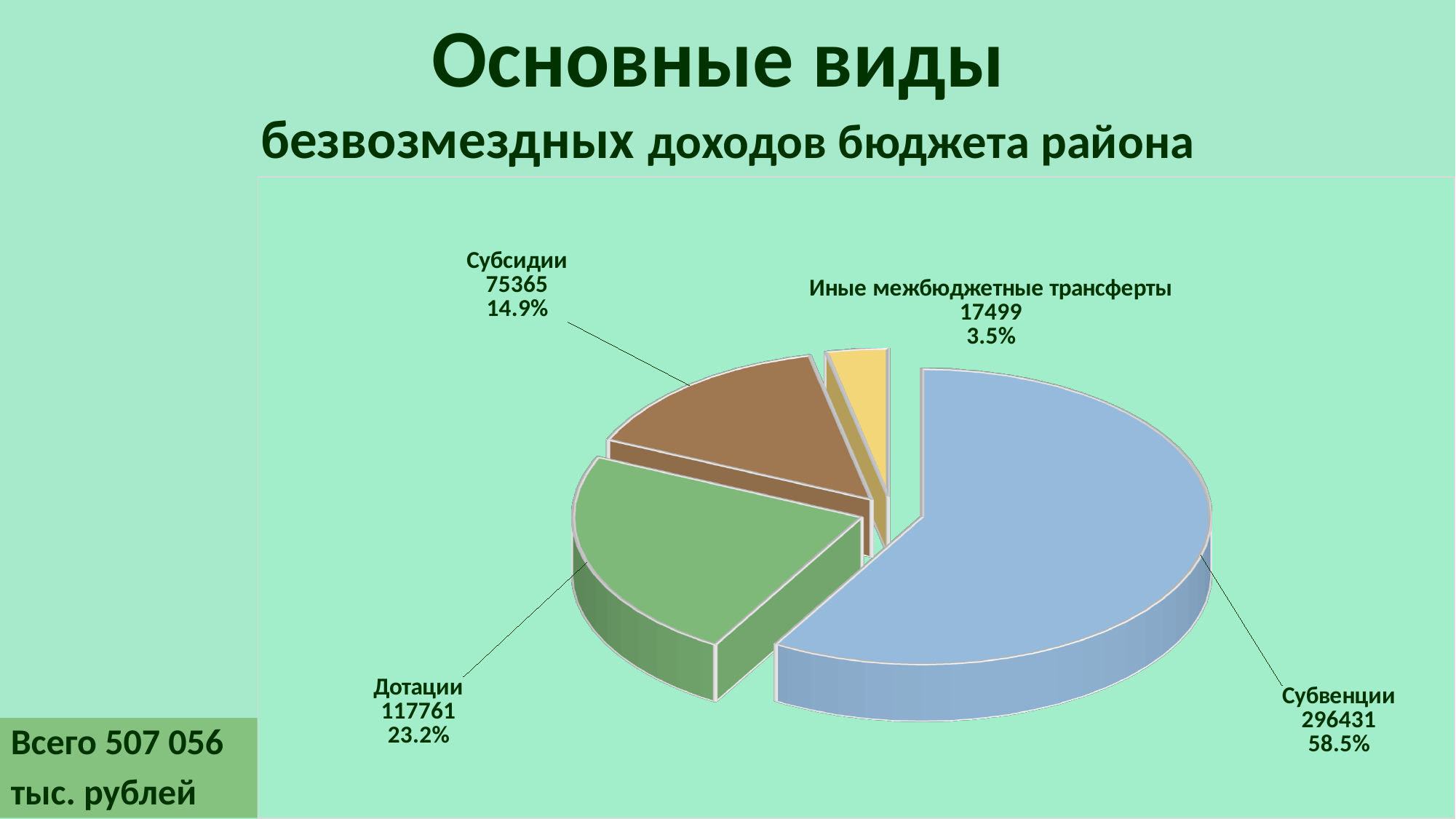
What is the value for Субсидии? 75365 What kind of chart is shown on the slide? Pie chart What is the value for Иные межбюджетные трансферты? 17499 Which is larger, Субсидии or Иные межбюджетные трансферты? Субсидии Which category has the smallest slice? Иные межбюджетные трансферты What is the value for Субвенции? 296431 What is the difference between the values for Субвенции and Дотации? 178670 Which category has the largest slice? Субвенции What share of the pie does Субсидии represent? 14.9% How many slices does the pie chart have? 4 What is the value for Дотации? 117761 What share of the pie does Дотации represent? 23.2%